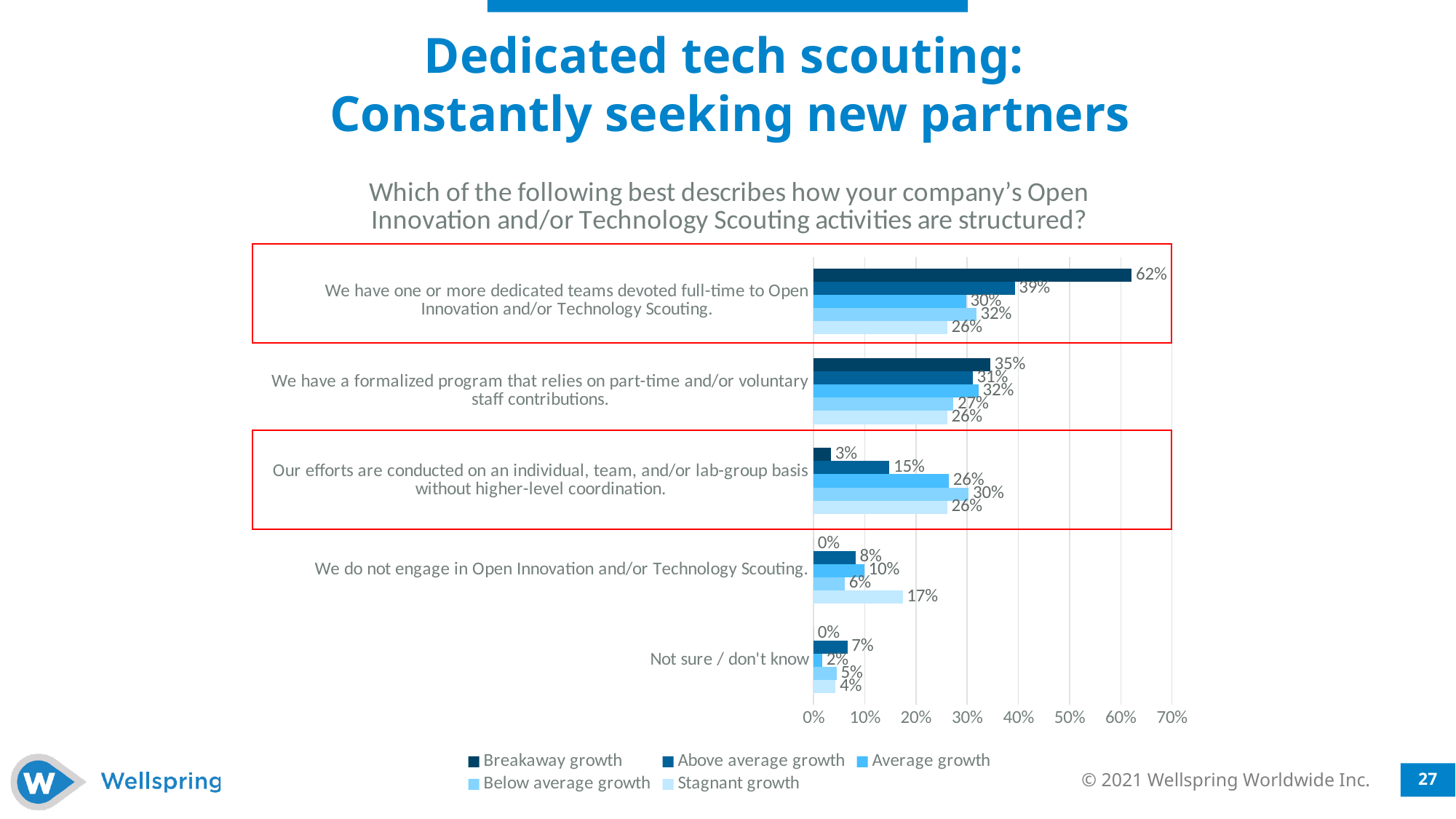
What is the Breakaway growth value for "Not sure / don't know"? 0% What kind of chart is shown on the slide? bar chart Which series has the lowest value for "Our efforts are conducted on an individual, team, and/or lab-group basis without higher-level coordination"? Breakaway growth Which response category has the highest Breakaway growth value? We have one or more dedicated teams devoted full-time to Open Innovation and/or Technology Scouting. For "We have a formalized program that relies on part-time and/or voluntary staff contributions", which is larger: the Breakaway growth value or the Stagnant growth value? Breakaway growth What is the Breakaway growth value for "We have one or more dedicated teams devoted full-time to Open Innovation and/or Technology Scouting"? 62% How many response categories are plotted on the chart? 5 Is the Breakaway growth value for "We have one or more dedicated teams devoted full-time to Open Innovation and/or Technology Scouting" greater or less than 50%? greater How many series does the legend list? 5 What is the Stagnant growth value for "We do not engage in Open Innovation and/or Technology Scouting"? 17% What is the difference between the Breakaway growth and Above average growth values for "We have one or more dedicated teams devoted full-time to Open Innovation and/or Technology Scouting"? 23% What is the Above average growth value for "Our efforts are conducted on an individual, team, and/or lab-group basis without higher-level coordination"? 15%